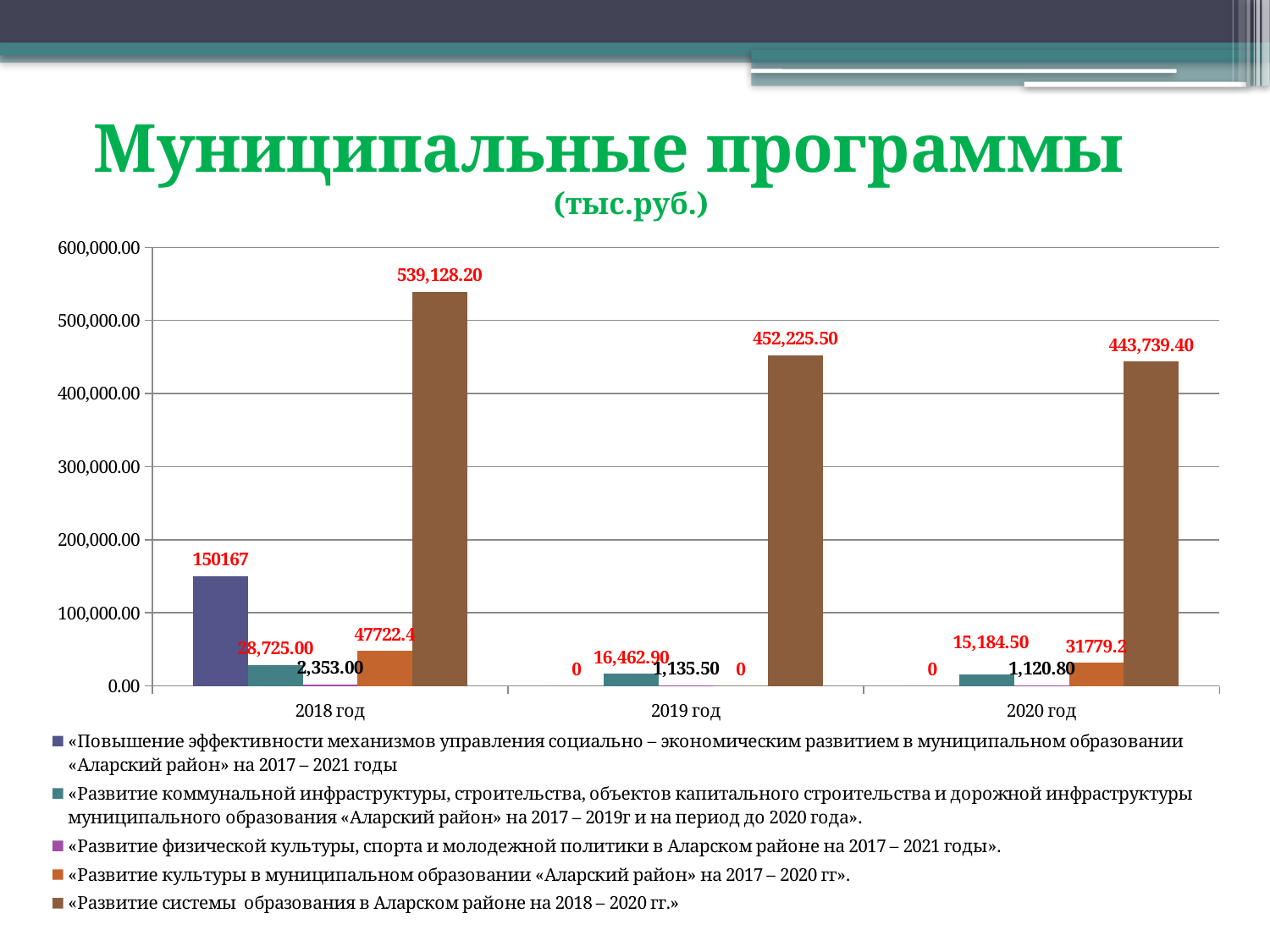
Which year has the highest value for the «Развитие системы образования» series? 2018 год What is the value for the «Развитие коммунальной инфраструктуры...» series in 2020 год? 15,184.50 What kind of chart is shown on the slide? bar chart What is the difference between the «Развитие системы образования» values for 2018 год and 2019 год? 86,902.70 Which is larger in 2018 год: the «Развитие культуры» value or the «Развитие коммунальной инфраструктуры» value? «Развитие культуры» (47722.4) How many year categories are shown on the x axis? 3 What is the value for the «Развитие системы образования» series in 2019 год? 452,225.50 What is the value for the «Развитие системы образования» series in 2020 год? 443,739.40 How many series does the legend list? 5 What is the value for the «Развитие системы образования» series in 2018 год? 539,128.20 Does the «Развитие системы образования» value fall or rise from 2018 год to 2020 год? fall What is the value for the «Повышение эффективности механизмов управления...» series in 2018 год? 150167